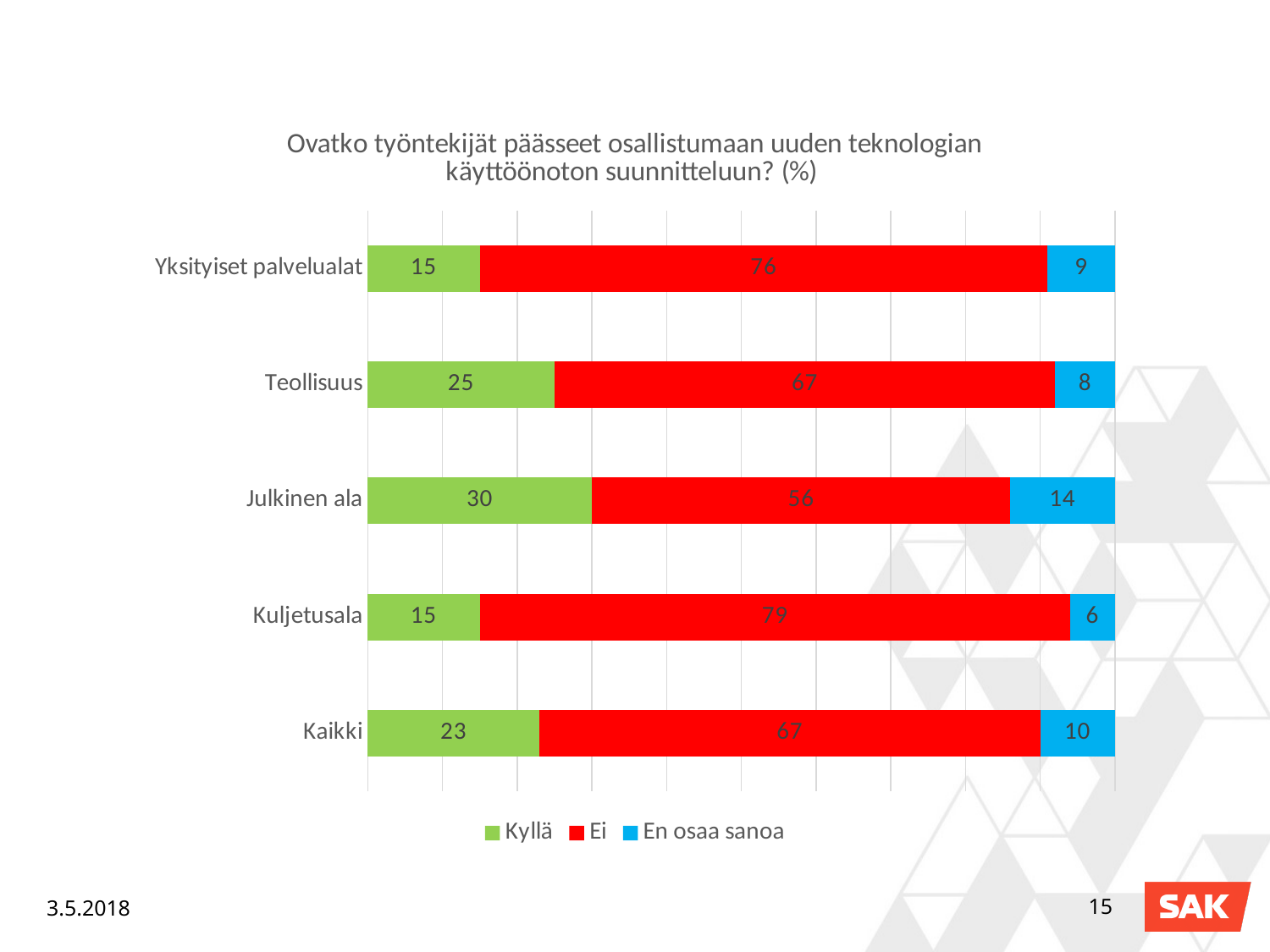
Which category has the lowest "En osaa sanoa" value? Kuljetusala How many categories are shown on the chart? 5 What is the difference between the "Kyllä" values for Julkinen ala and Yksityiset palvelualat? 15 What is the total of the stacked bar for Julkinen ala? 100 Which series is shown in red? Ei What kind of chart is shown on the slide? Stacked bar chart What is the "Ei" value for Kuljetusala? 79 How many series does the legend list? 3 What is the "Kyllä" value for Julkinen ala? 30 Which is larger: the "Kyllä" value for Teollisuus or for Kaikki? Teollisuus What is the "En osaa sanoa" value for Kaikki? 10 Which category has the highest "Ei" value? Kuljetusala